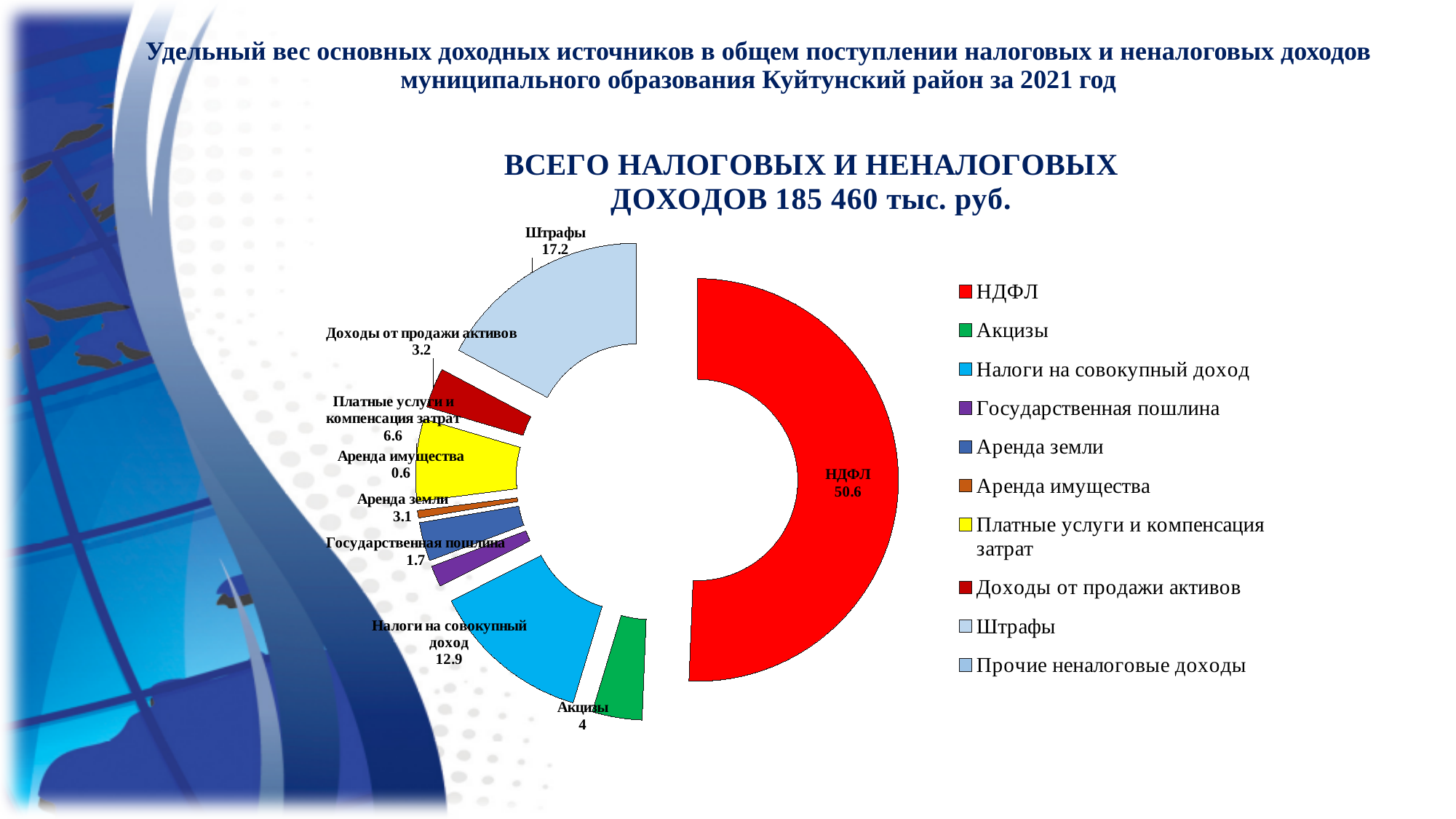
According to the chart heading, what is the total of tax and non-tax revenues? 185 460 тыс. руб. What is the difference between the values for Штрафы and Акцизы? 13.2 What is the difference between the values for НДФЛ and Налоги на совокупный доход? 37.7 Which labelled category has the smallest value on the chart? Аренда имущества What is the value shown for Штрафы on the chart? 17.2 What kind of chart is shown on the slide? doughnut chart Which category has the largest share on the chart? НДФЛ Which is larger, the value for Штрафы or the value for Налоги на совокупный доход? Штрафы How many entries does the chart legend list? 10 What is the value shown for НДФЛ on the chart? 50.6 What is the value shown for Акцизы on the chart? 4 What is the value shown for Налоги на совокупный доход on the chart? 12.9